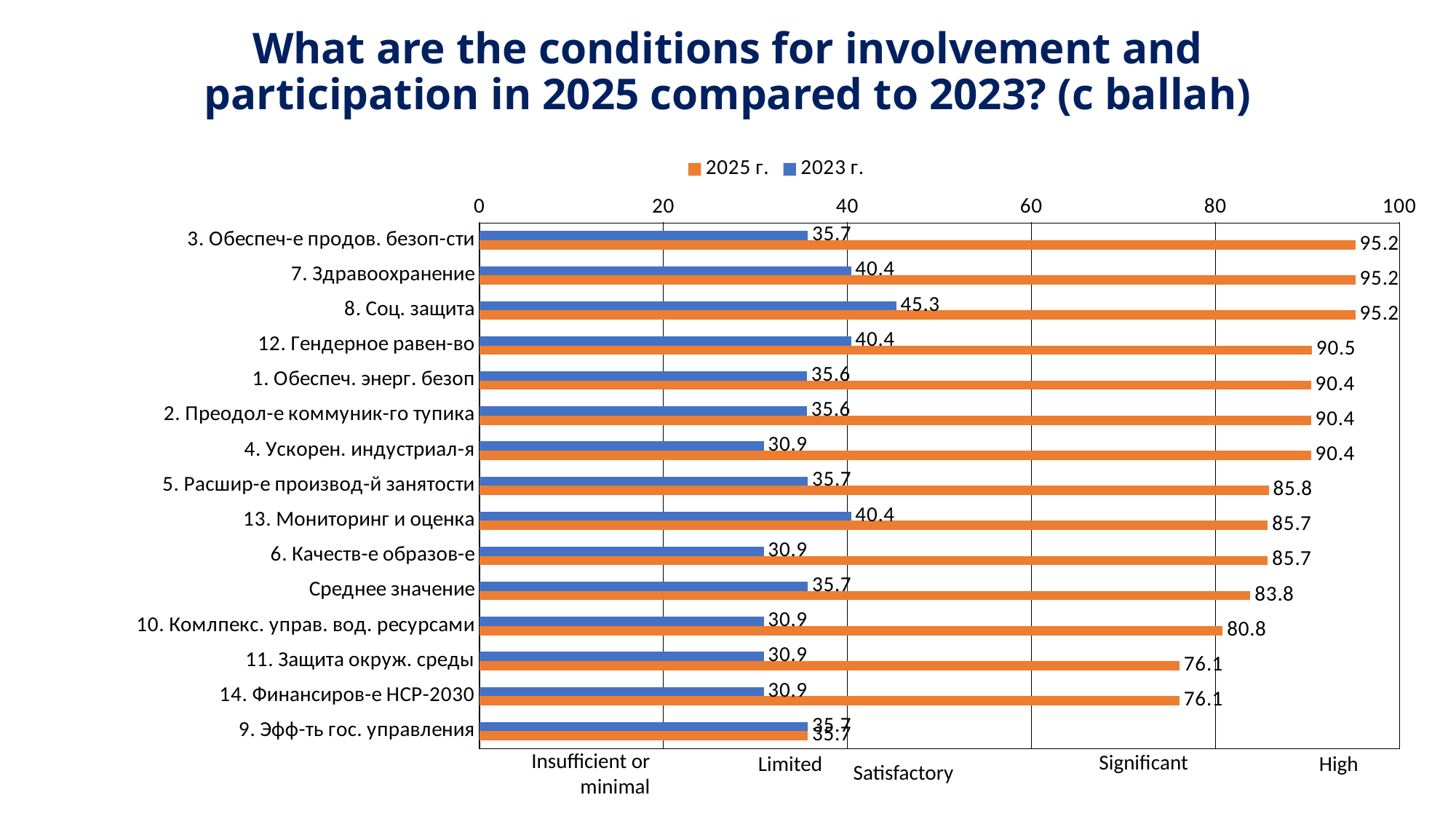
What is the 2025 г. value for Среднее значение? 83.8 What is the difference between the 2025 г. and 2023 г. values for Среднее значение? 48.1 What type of chart is shown on the slide? bar chart What is the 2025 г. value for 8. Соц. защита? 95.2 Which colour represents the 2023 г. series? blue What is the 2023 г. value for 4. Ускорен. индустриал-я? 30.9 Which category has the lowest 2025 г. value? 9. Эфф-ть гос. управления How many series does the legend list? 2 Is the 2025 г. value for 14. Финансиров-е НСР-2030 greater or less than 80? less Which is larger: the 2025 г. value for 10. Комлпекс. управ. вод. ресурсами or the 2025 г. value for 11. Защита окруж. среды? 10. Комлпекс. управ. вод. ресурсами Which category has the highest 2023 г. value? 8. Соц. защита How many categories are plotted on the chart? 15